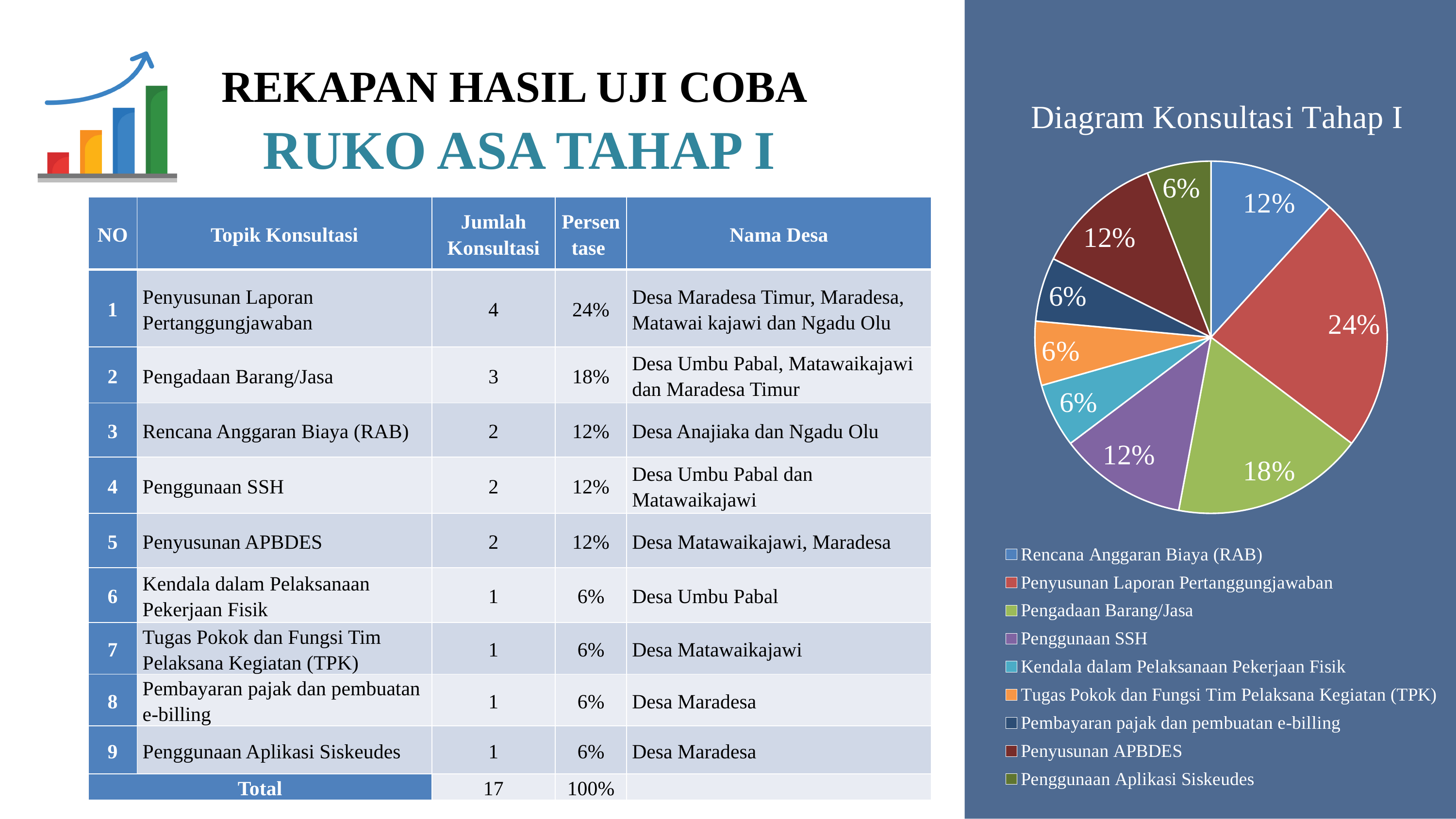
How many slices does the pie chart have? 9 What is the title of the chart? Diagram Konsultasi Tahap I Which slice is larger, Rencana Anggaran Biaya (RAB) or Kendala dalam Pelaksanaan Pekerjaan Fisik? Rencana Anggaran Biaya (RAB) What share of the pie does Pengguna Aplikasi Siskeudes have? 6% Which category has the largest slice of the pie? Penyusunan Laporan Pertanggungjawaban What share of the pie does Pengadaan Barang/Jasa have? 18% What kind of chart is shown on the slide? pie chart How many entries does the legend list? 9 What is the difference in percentage points between the Penyusunan Laporan Pertanggungjawaban slice and the Pengadaan Barang/Jasa slice? 6% What colour is the Pengadaan Barang/Jasa slice? green What share of the pie does Penyusunan Laporan Pertanggungjawaban have? 24%